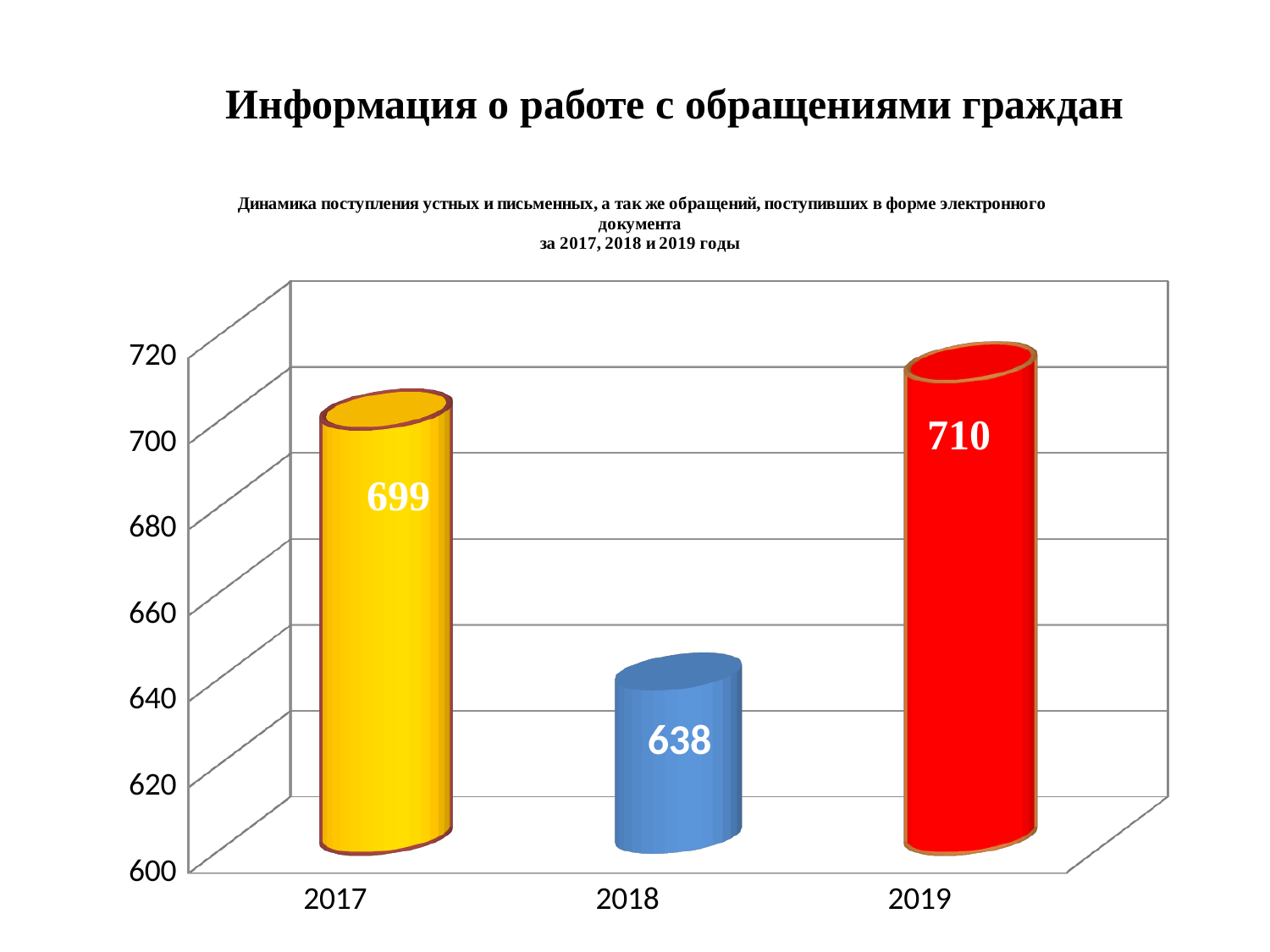
What kind of chart is shown on the slide? bar chart What is the value for 2017? 699 Which is larger, the value for 2017 or the value for 2018? 2017 How many years are shown on the x axis? 3 What is the value for 2018? 638 What is the difference between the values for 2019 and 2018? 72 Which year has the highest value? 2019 What is the value for 2019? 710 Which year has the lowest value? 2018 Is the value for 2018 greater or less than 640? less What is the difference between the values for 2019 and 2017? 11 What colour is the bar for 2019? red